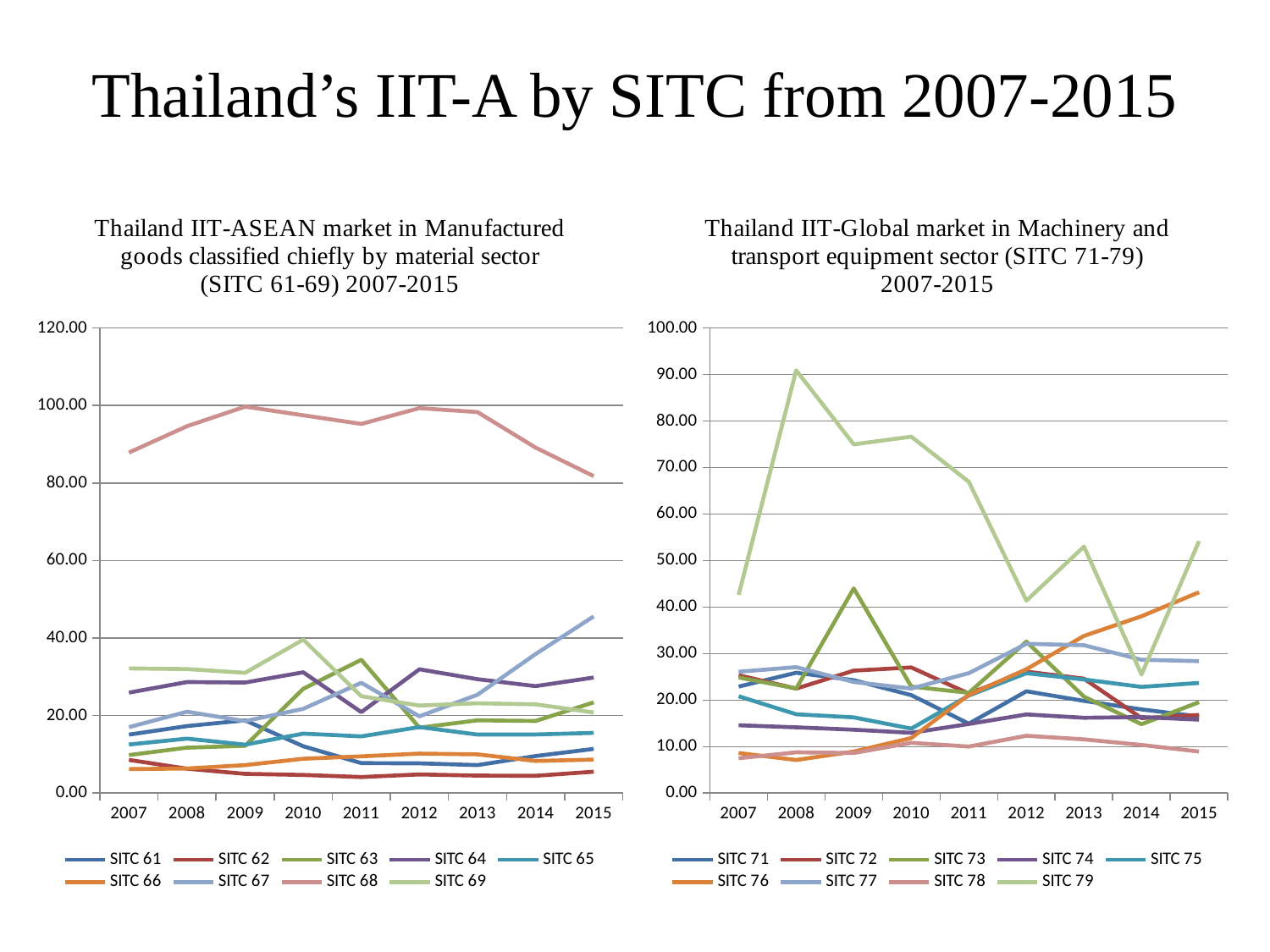
How many years are plotted along the x axis of the left chart (SITC 61-69)? 9 In the right chart (SITC 71-79), which is larger in 2015, SITC 79 or SITC 76? SITC 79 In the right chart (SITC 71-79), in which year does SITC 79 reach its highest value? 2008 In the right chart (SITC 71-79), which series has the lowest value in 2015? SITC 78 In the left chart (SITC 61-69), which series has the highest values across all years? SITC 68 In the left chart (SITC 61-69), which series has the lowest value in 2015? SITC 62 In the right chart (SITC 71-79), does the value for SITC 76 rise or fall from 2008 to 2015? Rise How many series does the legend of the right chart, 'Thailand IIT-Global market in Machinery and transport equipment sector (SITC 71-79) 2007-2015', list? 9 In the left chart (SITC 61-69), is the value for SITC 67 in 2015 greater or less than 40.00? greater What kind of chart is the left chart, 'Thailand IIT-ASEAN market in Manufactured goods classified chiefly by material sector (SITC 61-69) 2007-2015'? Line chart In the left chart (SITC 61-69), which is larger in 2015, SITC 67 or SITC 64? SITC 67